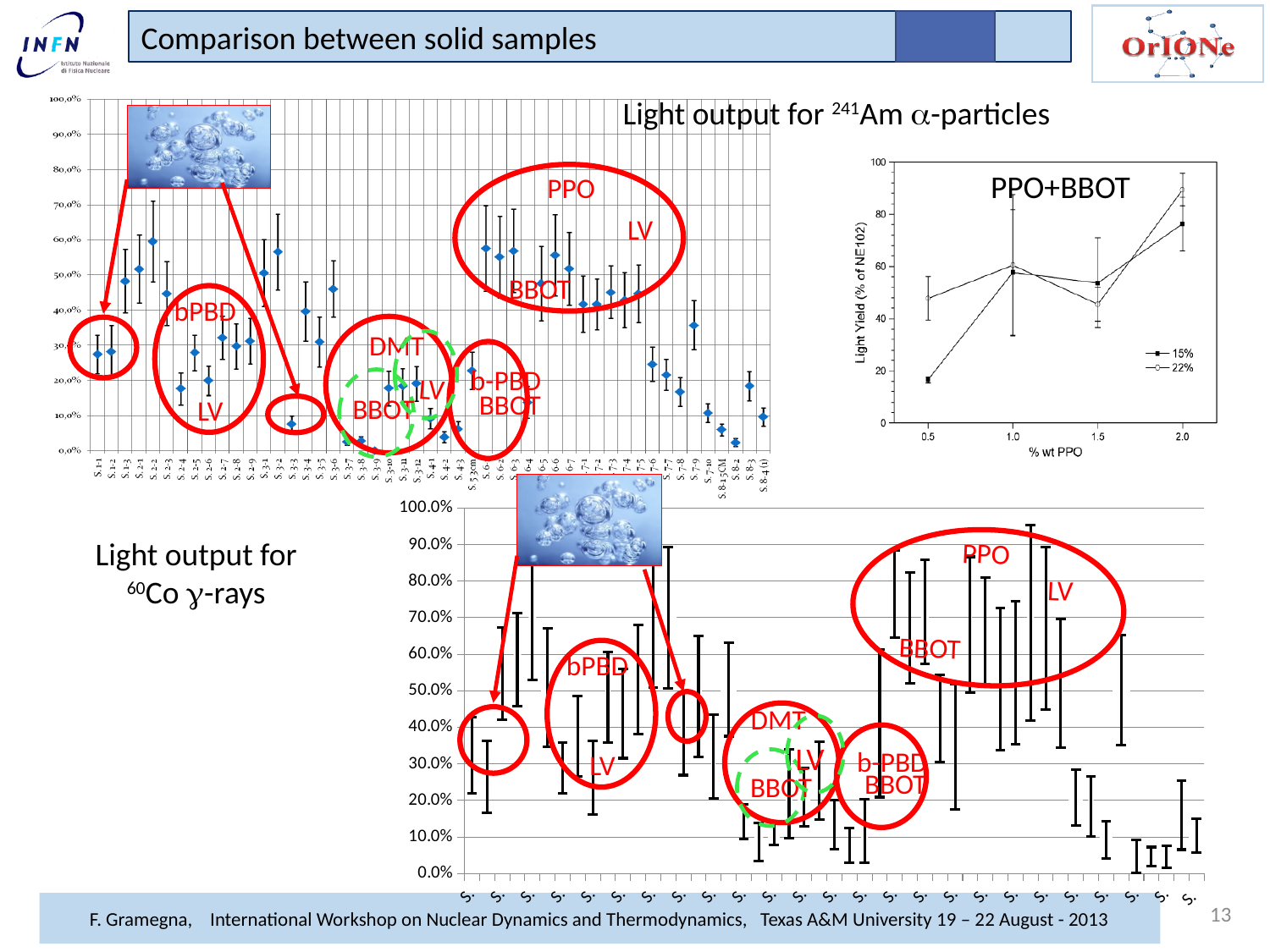
In the PPO+BBOT chart, is the light yield of the 15% series at 0.5 % wt PPO greater or less than 20? less In the PPO+BBOT chart, which series has the higher light yield at 2.0 % wt PPO, 15% or 22%? 22% In the PPO+BBOT chart, at which % wt PPO value does the 22% series reach its highest light yield? 2.0 In the PPO+BBOT chart, how many % wt PPO points are plotted for each series? 4 In the PPO+BBOT chart, is the light yield of the 15% series at 2.0 % wt PPO greater or less than 60? greater In the PPO+BBOT chart, what are the two series named in the legend? 15% and 22% What kind of chart is the PPO+BBOT chart? line chart In the PPO+BBOT chart, what is the label of the y axis? Light Yield (% of NE102) In the PPO+BBOT chart, which series has the higher light yield at 0.5 % wt PPO, 15% or 22%? 22% In the PPO+BBOT chart, how many series does the legend list? 2 In the PPO+BBOT chart, is the light yield of the 22% series at 2.0 % wt PPO greater or less than 80? greater In the PPO+BBOT chart, at which % wt PPO value does the 15% series reach its lowest light yield? 0.5